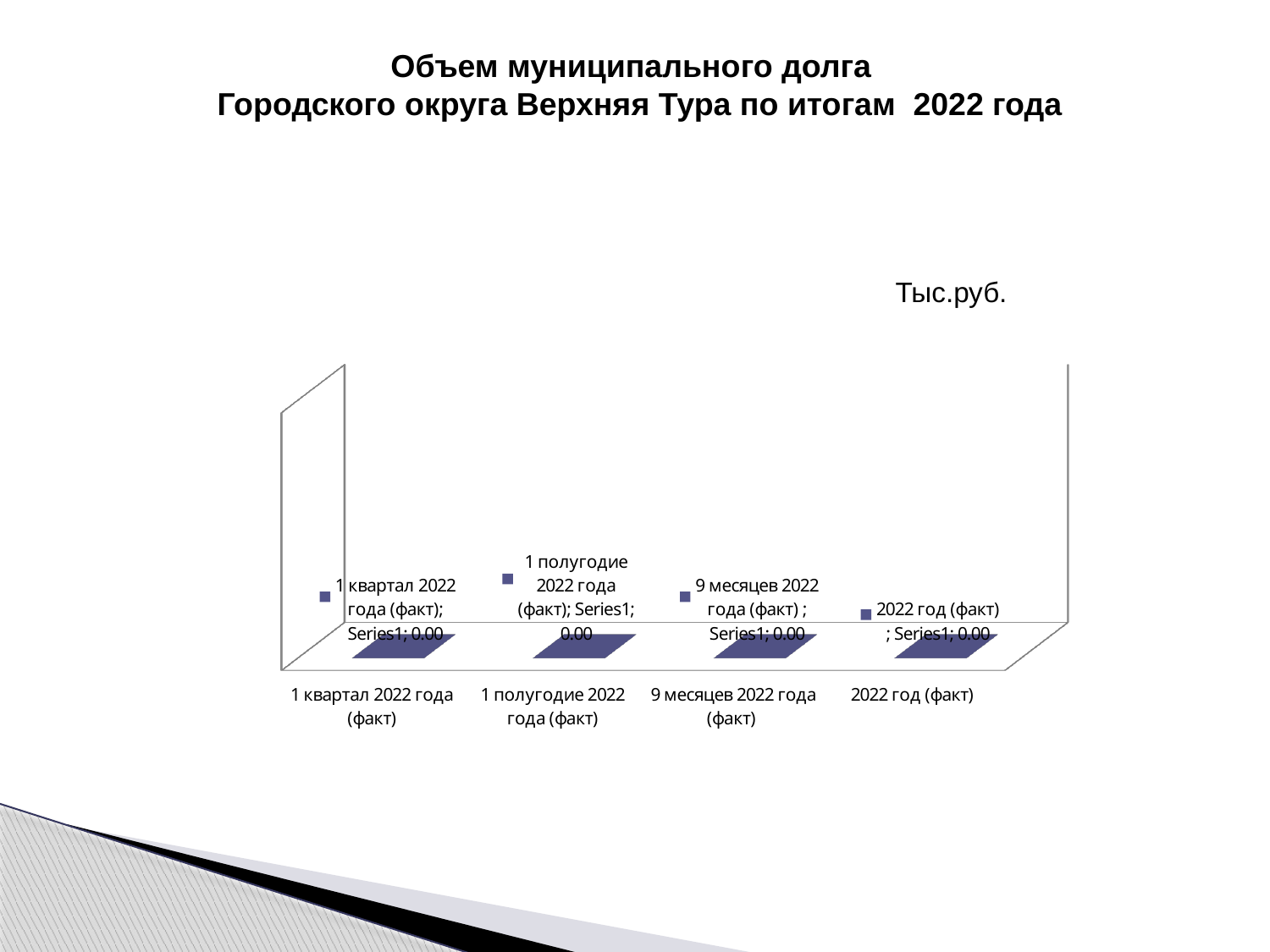
How many categories are shown on the x axis of the chart? 4 What unit of measurement is indicated above the chart? Тыс.руб. What kind of chart is shown on the slide? bar chart What is the value for '1 квартал 2022 года (факт)'? 0.00 What is the value for '1 полугодие 2022 года (факт)'? 0.00 What is the name of the series shown in the data labels? Series1 Do the values rise, fall, or stay the same from '1 квартал 2022 года (факт)' to '2022 год (факт)'? stay the same What is the value for '2022 год (факт)'? 0.00 What is the value for '9 месяцев 2022 года (факт)'? 0.00 What is the difference between the values for '2022 год (факт)' and '1 квартал 2022 года (факт)'? 0.00